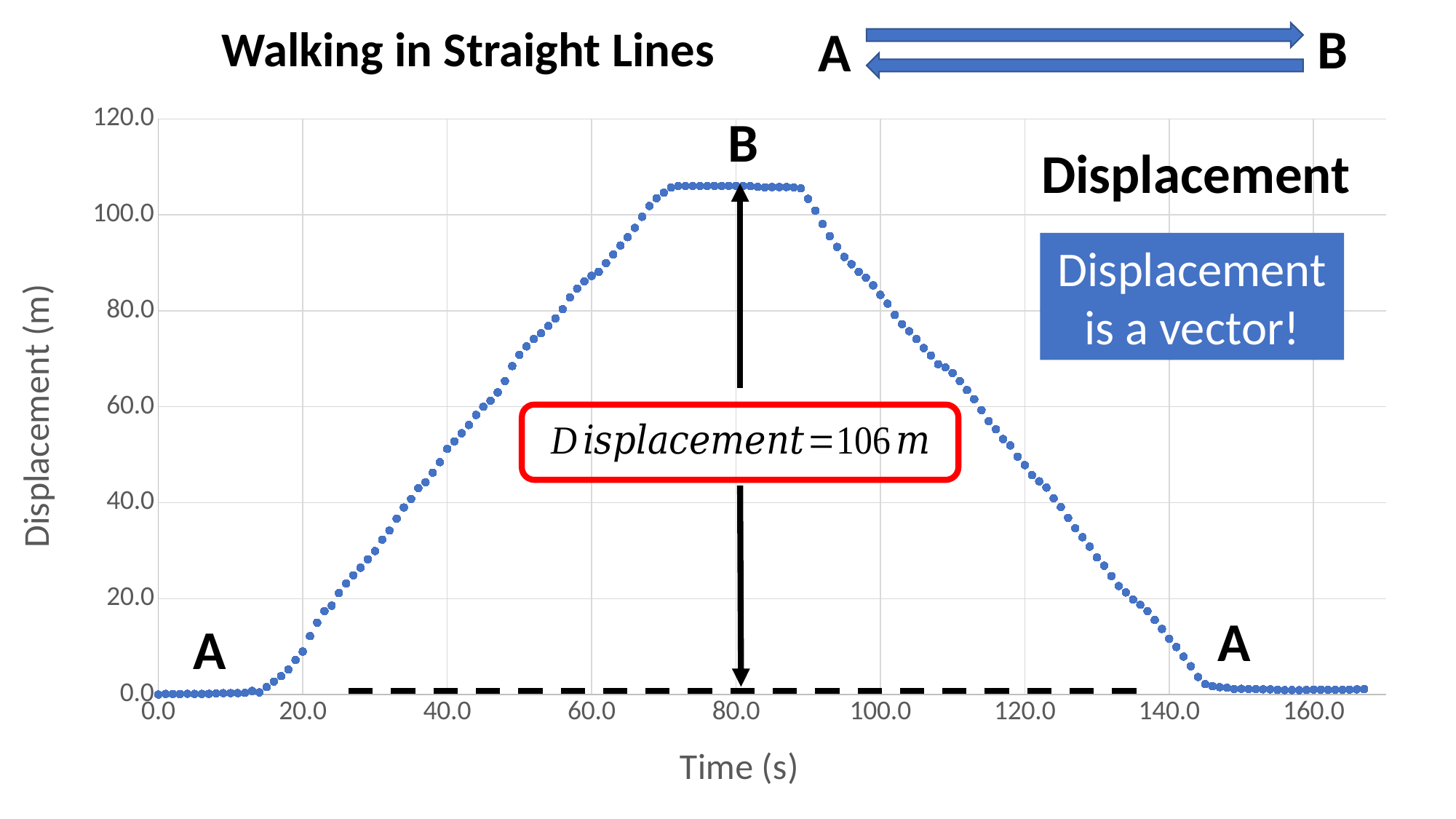
What is the title of the chart? Walking in Straight Lines What kind of chart is shown on the slide? scatter chart Is the displacement at 140.0 s greater or less than 20.0 m? less Does the displacement rise or fall between 100.0 s and 140.0 s? fall What is the maximum displacement reached at point B, as printed on the slide? 106 m Which is larger, the displacement at 80.0 s or the displacement at 160.0 s? 80.0 s What is the label of the vertical axis? Displacement (m) Does the displacement rise or fall between 20.0 s and 60.0 s? rise Is the displacement at 40.0 s greater or less than 40.0 m? greater Is the displacement at 120.0 s greater or less than 40.0 m? greater What is the highest value shown on the vertical axis? 120.0